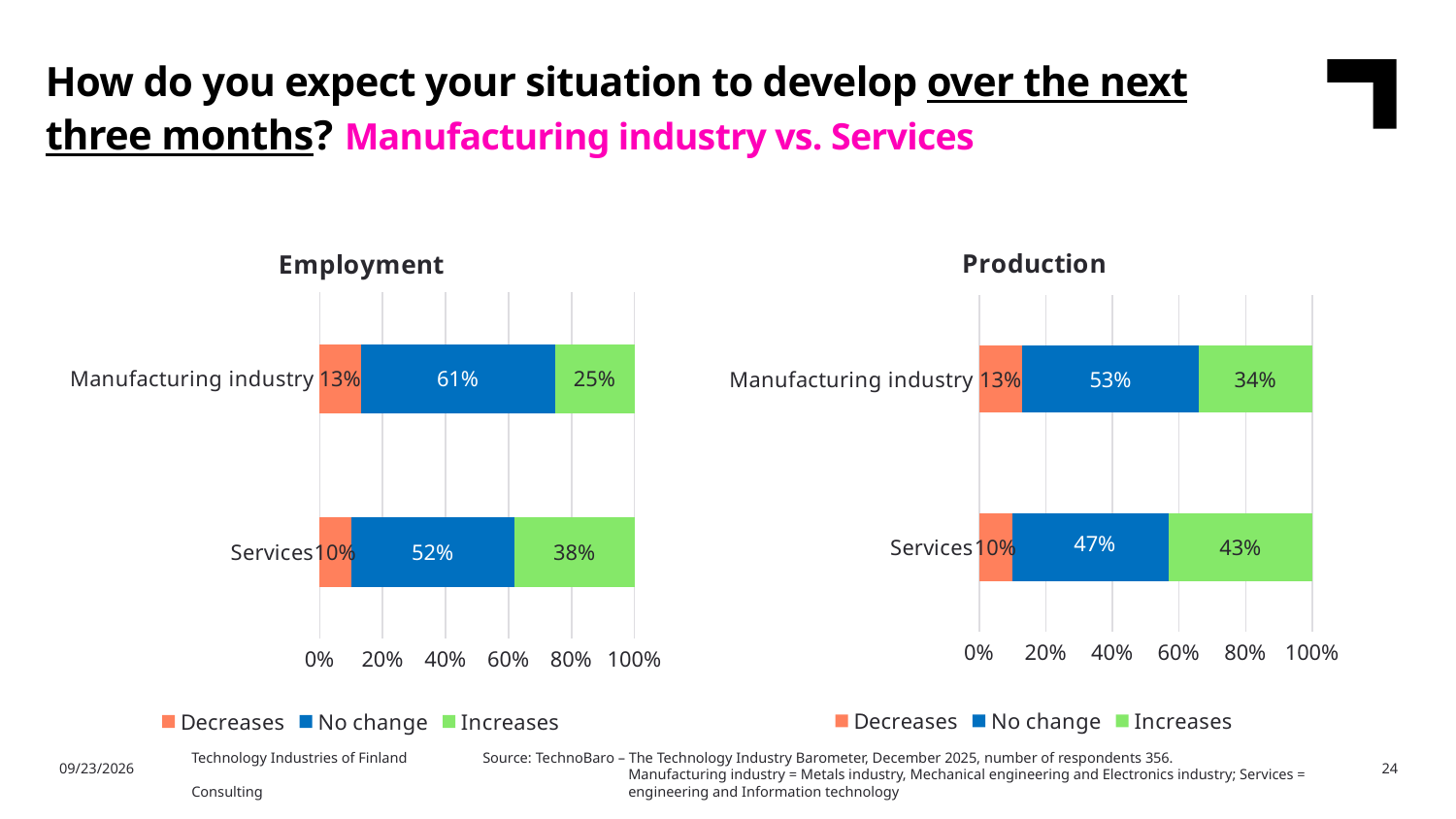
In the Production chart, what percentage of Manufacturing industry respondents expect increases? 34% How many series does the legend of the Production chart list? 3 What kind of chart is the Production chart? Stacked bar chart In the Production chart, which category has the higher share of respondents expecting no change? Manufacturing industry In the Employment chart, what percentage of Services respondents expect decreases? 10% In the Employment chart, which category has the higher share of respondents expecting increases? Services In the Employment chart, what is the difference between the Increases share for Services and for Manufacturing industry? 13% In the Employment chart, which colour represents the Decreases series? Orange How many categories are shown in the Employment chart? 2 In the Production chart, what percentage of Services respondents expect increases? 43% In the Employment chart, what percentage of Manufacturing industry respondents expect no change? 61% In the Production chart, what is the difference between the No change share for Manufacturing industry and for Services? 6%